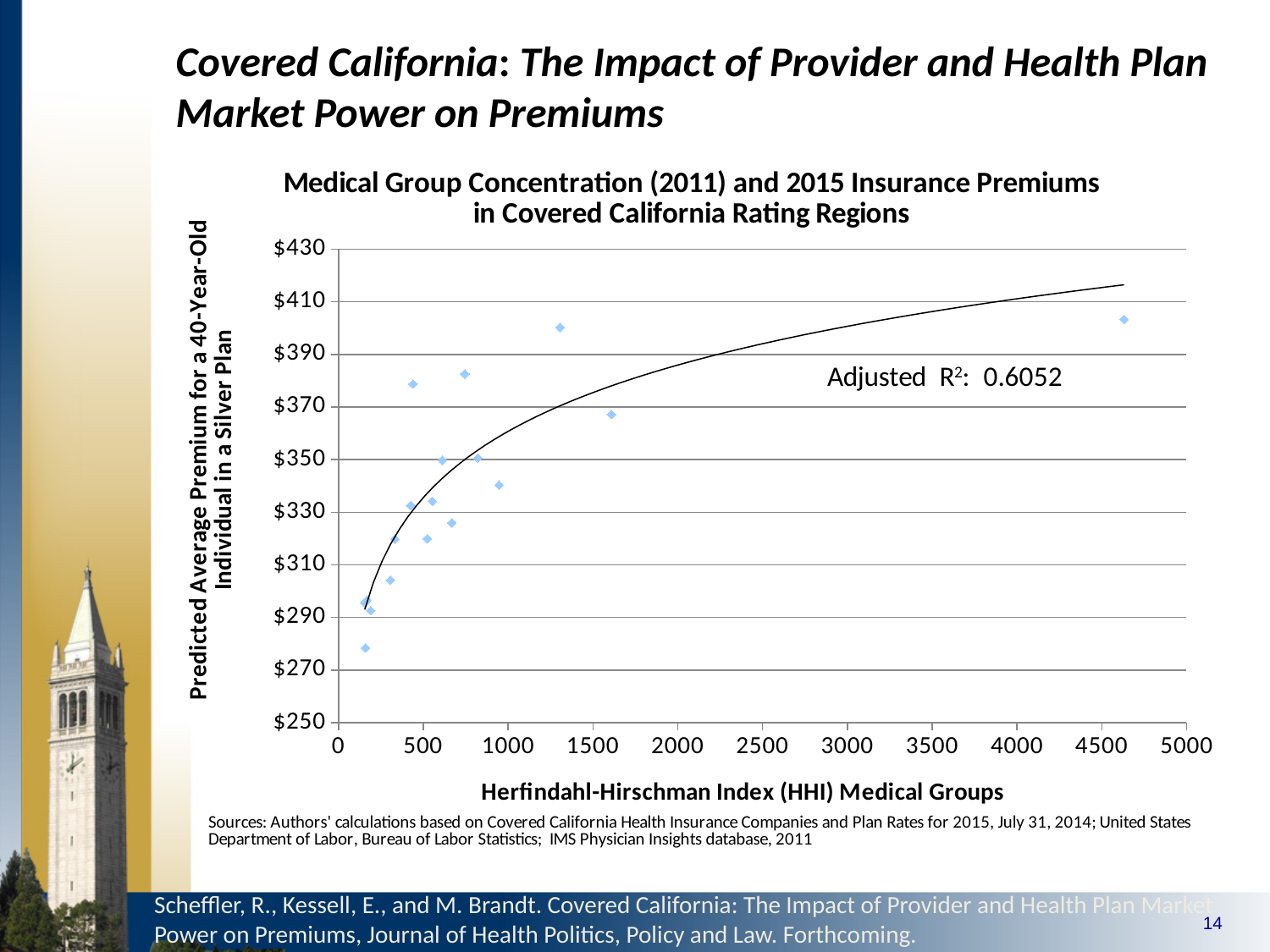
What is the title of the chart? Medical Group Concentration (2011) and 2015 Insurance Premiums in Covered California Rating Regions Is the predicted premium for the point near HHI 1600 greater or less than $370? less What Adjusted R² value is printed on the chart? 0.6052 Are any of the plotted points above $410 on the y axis? no Is the HHI of the rightmost point greater or less than 4500? greater As the Herfindahl-Hirschman Index increases along the x axis, do the predicted premiums generally rise or fall? rise What kind of chart is shown on the slide? scatter chart